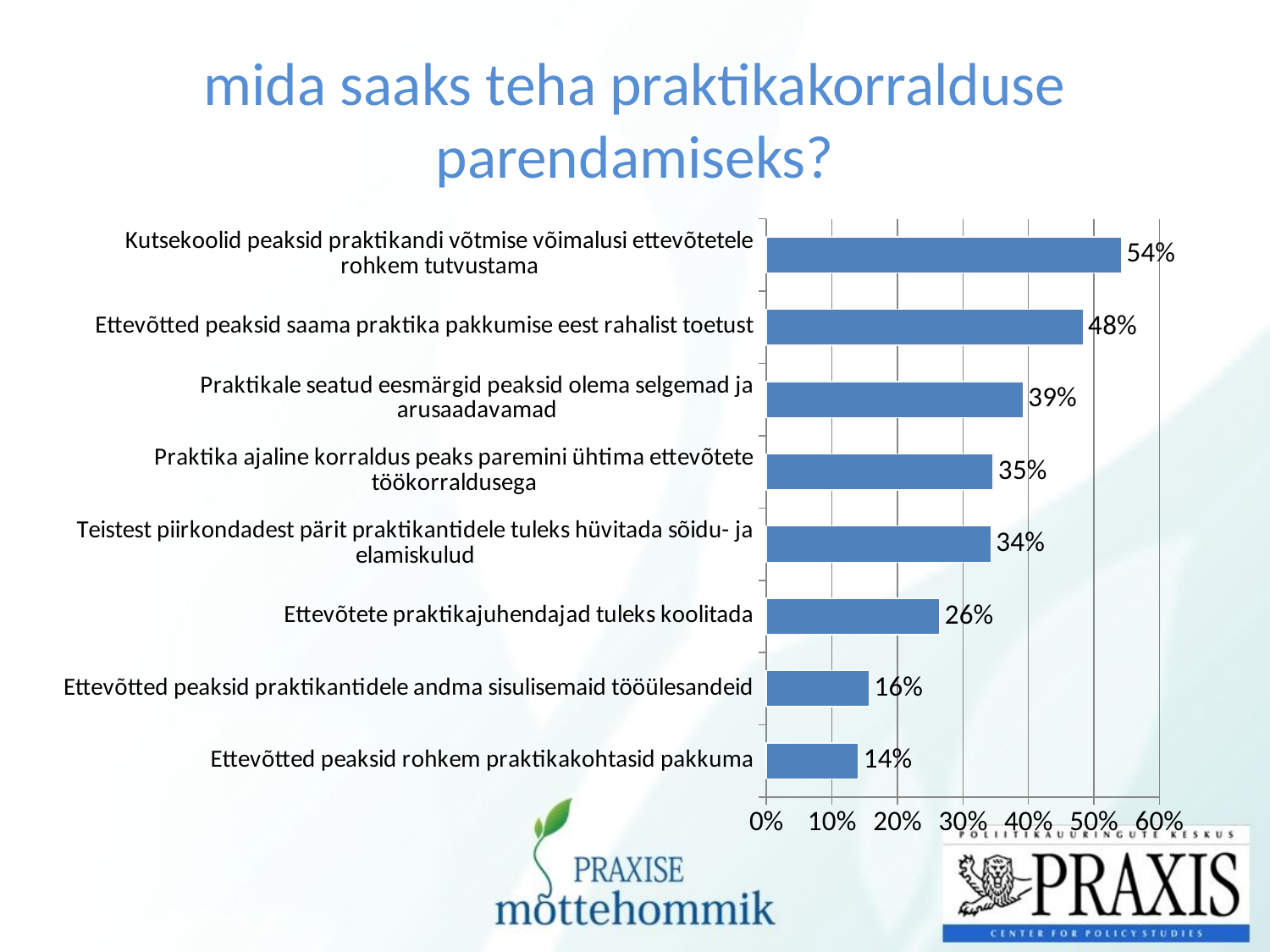
Which category has the lowest value? Ettevõtted peaksid rohkem praktikakohtasid pakkuma Which is larger: the value for "Praktikale seatud eesmärgid peaksid olema selgemad ja arusaadavamad" or for "Ettevõtete praktikajuhendajad tuleks koolitada"? Praktikale seatud eesmärgid peaksid olema selgemad ja arusaadavamad What is the value for "Ettevõtted peaksid saama praktika pakkumise eest rahalist toetust"? 48% Which category has the highest value? Kutsekoolid peaksid praktikandi võtmise võimalusi ettevõtetele rohkem tutvustama What is the value for "Ettevõtted peaksid rohkem praktikakohtasid pakkuma"? 14% Is the value for "Praktika ajaline korraldus peaks paremini ühtima ettevõtete töökorraldusega" greater or less than 30%? greater What is the difference between the values for "Ettevõtted peaksid praktikantidele andma sisulisemaid tööülesandeid" and "Ettevõtted peaksid rohkem praktikakohtasid pakkuma"? 2% What kind of chart is shown on the slide? bar chart What is the difference between the values for "Kutsekoolid peaksid praktikandi võtmise võimalusi ettevõtetele rohkem tutvustama" and "Ettevõtted peaksid saama praktika pakkumise eest rahalist toetust"? 6% What is the value for "Ettevõtete praktikajuhendajad tuleks koolitada"? 26% What is the title of the slide? mida saaks teha praktikakorralduse parendamiseks? How many categories are shown in the chart? 8